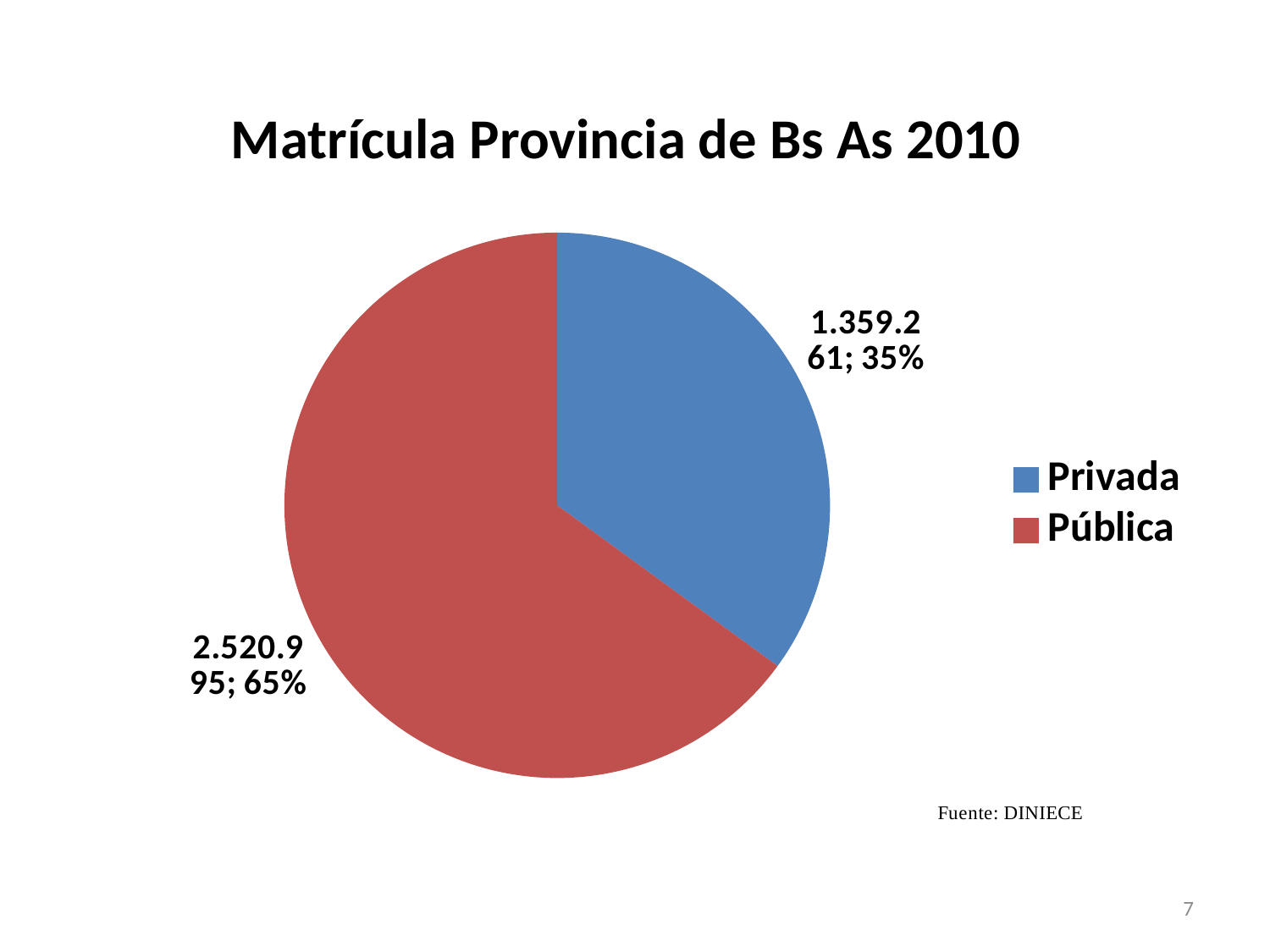
What is the value shown for Pública? 2.520.995 What is the title of the chart? Matrícula Provincia de Bs As 2010 Which colour represents Pública in the pie chart? red Which category has the smallest slice of the pie? Privada How many slices does the pie chart have? 2 What percentage share does the Privada slice represent? 35% What percentage share does the Pública slice represent? 65% What type of chart is shown on the slide? pie chart What is the value shown for Privada? 1.359.261 How many entries does the legend list? 2 Which category has the largest slice of the pie? Pública Which is larger, the value for Privada or the value for Pública? Pública